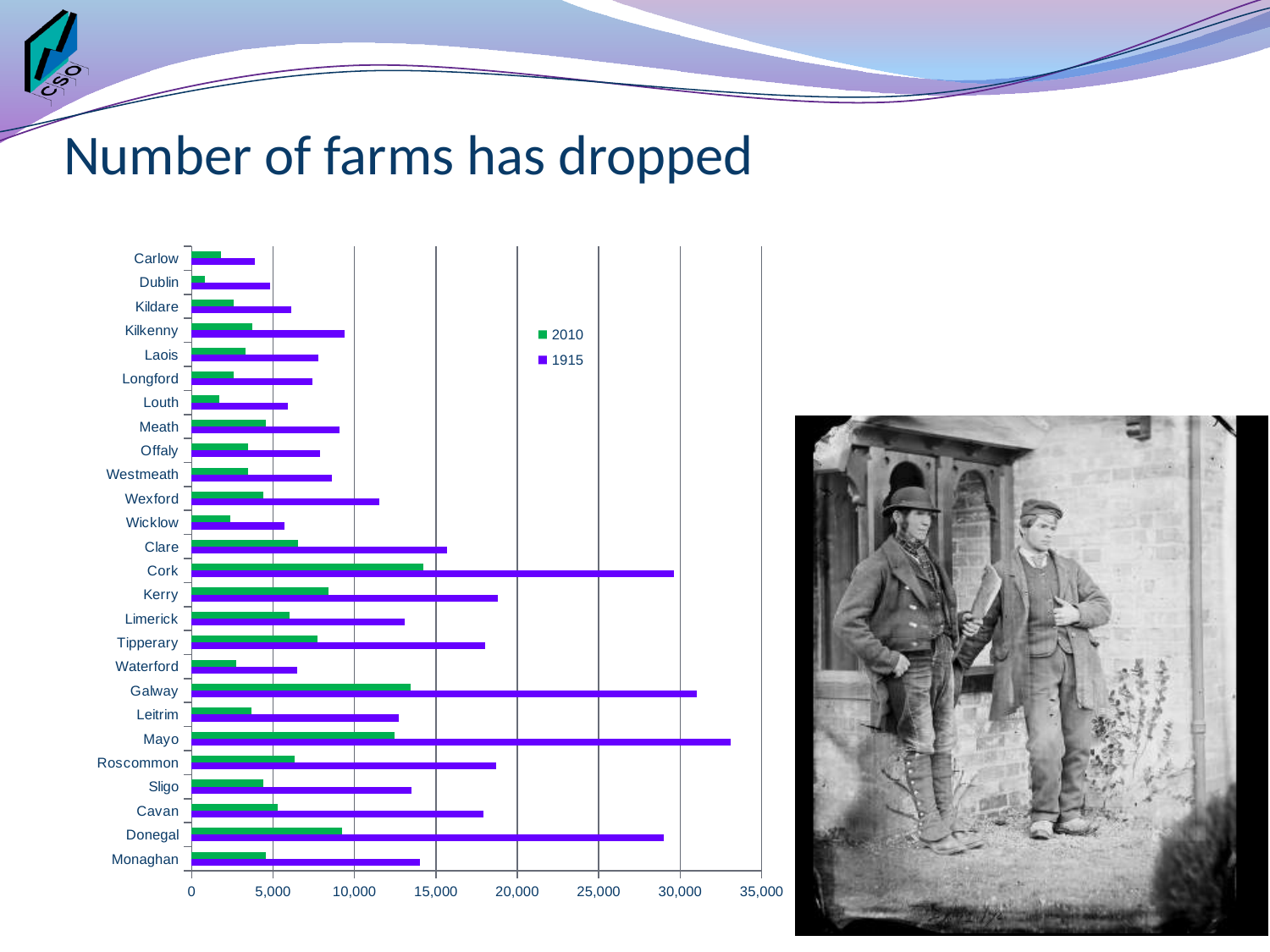
What kind of chart is shown on the slide? bar chart Which county has the lowest value for 1915? Carlow Is the 2010 value for Mayo greater or less than 10,000? greater Which county has the highest value for 1915? Mayo Is the 2010 value for Dublin greater or less than 5,000? less Is the 1915 value for Kerry greater or less than 20,000? less What is the title of the slide containing the chart? Number of farms has dropped How many series does the legend list? 2 Which is larger, the 1915 value for Galway or the 1915 value for Donegal? Galway Which county has the lowest value for 2010? Dublin How many counties are plotted on the chart? 26